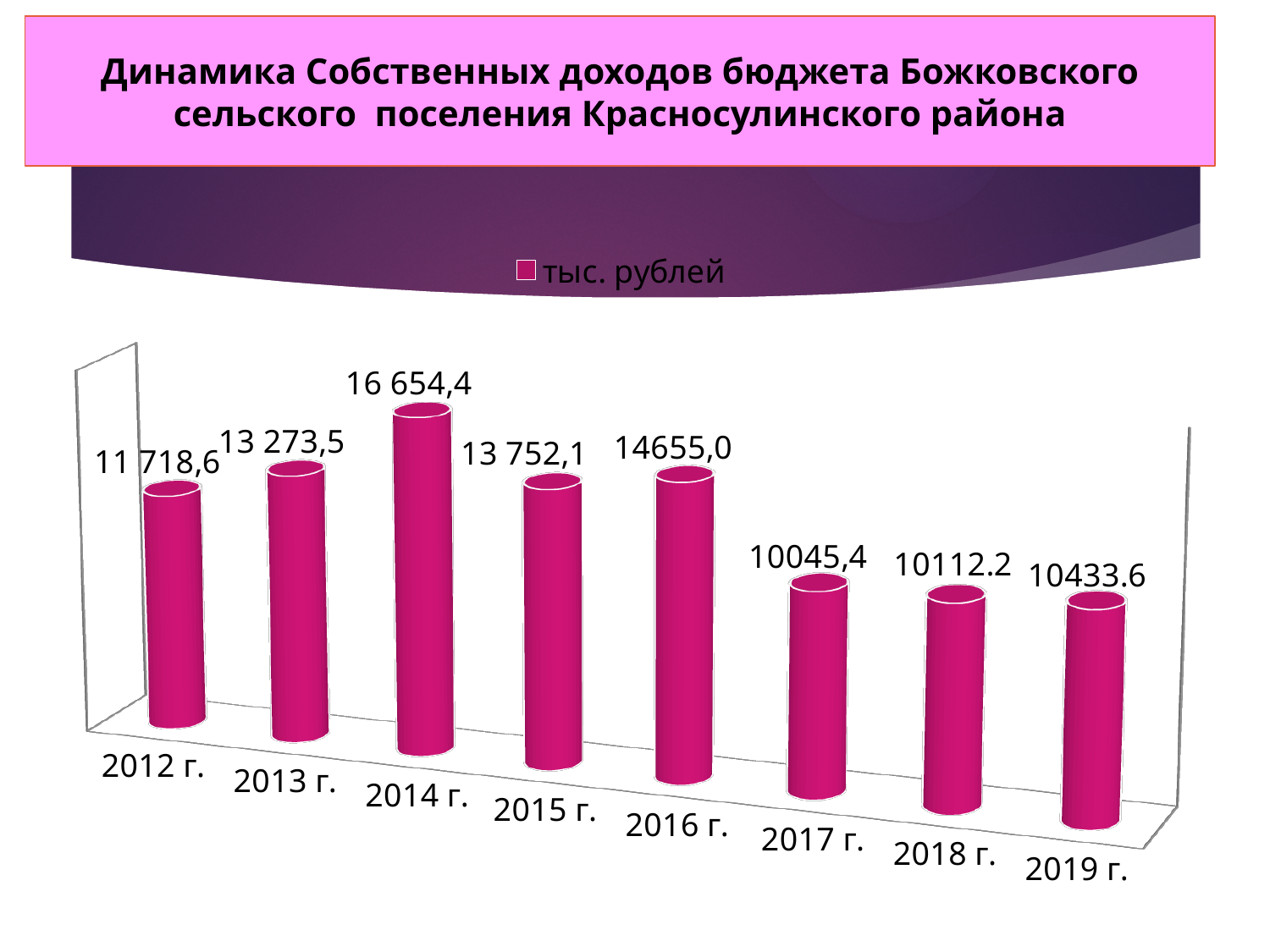
What is the value for 2014 г.? 16 654,4 Which is larger, the value for 2015 г. or the value for 2016 г.? 2016 г. Which year has the highest value? 2014 г. What is the difference between the values for 2014 г. and 2012 г.? 4 935,8 What is the value for 2012 г.? 11 718,6 Do the values rise or fall from 2012 г. to 2014 г.? rise Which year has the lowest value? 2017 г. What kind of chart is shown on the slide? bar chart What is the value for 2019 г.? 10433.6 What is the difference between the values for 2016 г. and 2017 г.? 4609,6 What is the value for 2017 г.? 10045,4 How many years are shown on the chart? 8